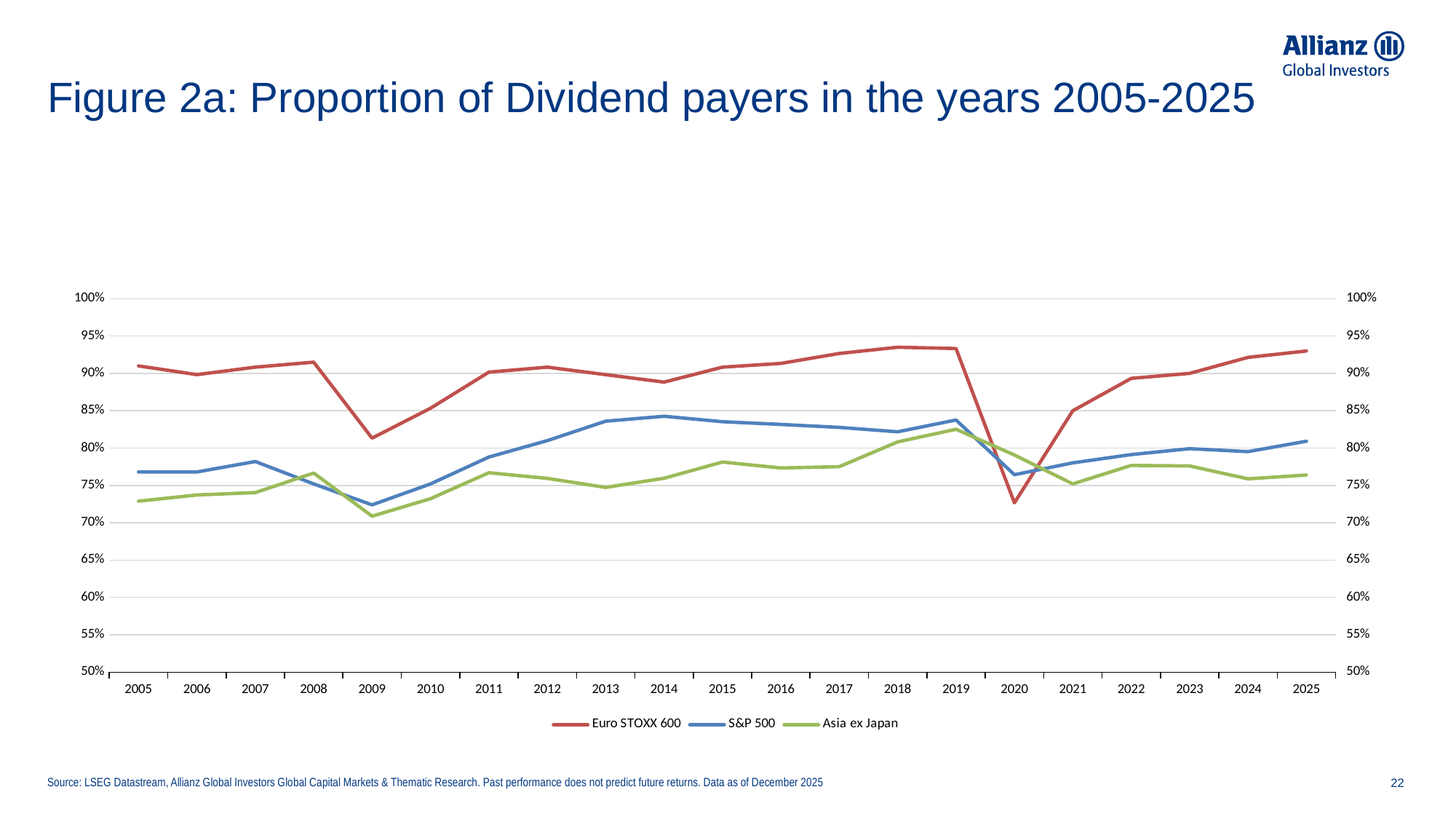
Is the value for Asia ex Japan in 2009 greater or less than 75%? less Which series has the highest value in 2005? Euro STOXX 600 How many years are shown on the x axis? 21 Is the value for Euro STOXX 600 in 2020 greater or less than 75%? less In 2025, which is larger: the S&P 500 value or the Asia ex Japan value? S&P 500 What kind of chart is shown on the slide? Line chart Which series has the lowest value in 2020? Euro STOXX 600 Does the Euro STOXX 600 line rise or fall from 2020 to 2025? rise Is the value for S&P 500 in 2014 greater or less than 80%? greater In which year does the Asia ex Japan line reach its highest point? 2019 In which year does the Euro STOXX 600 line reach its lowest point? 2020 How many series does the legend list? 3